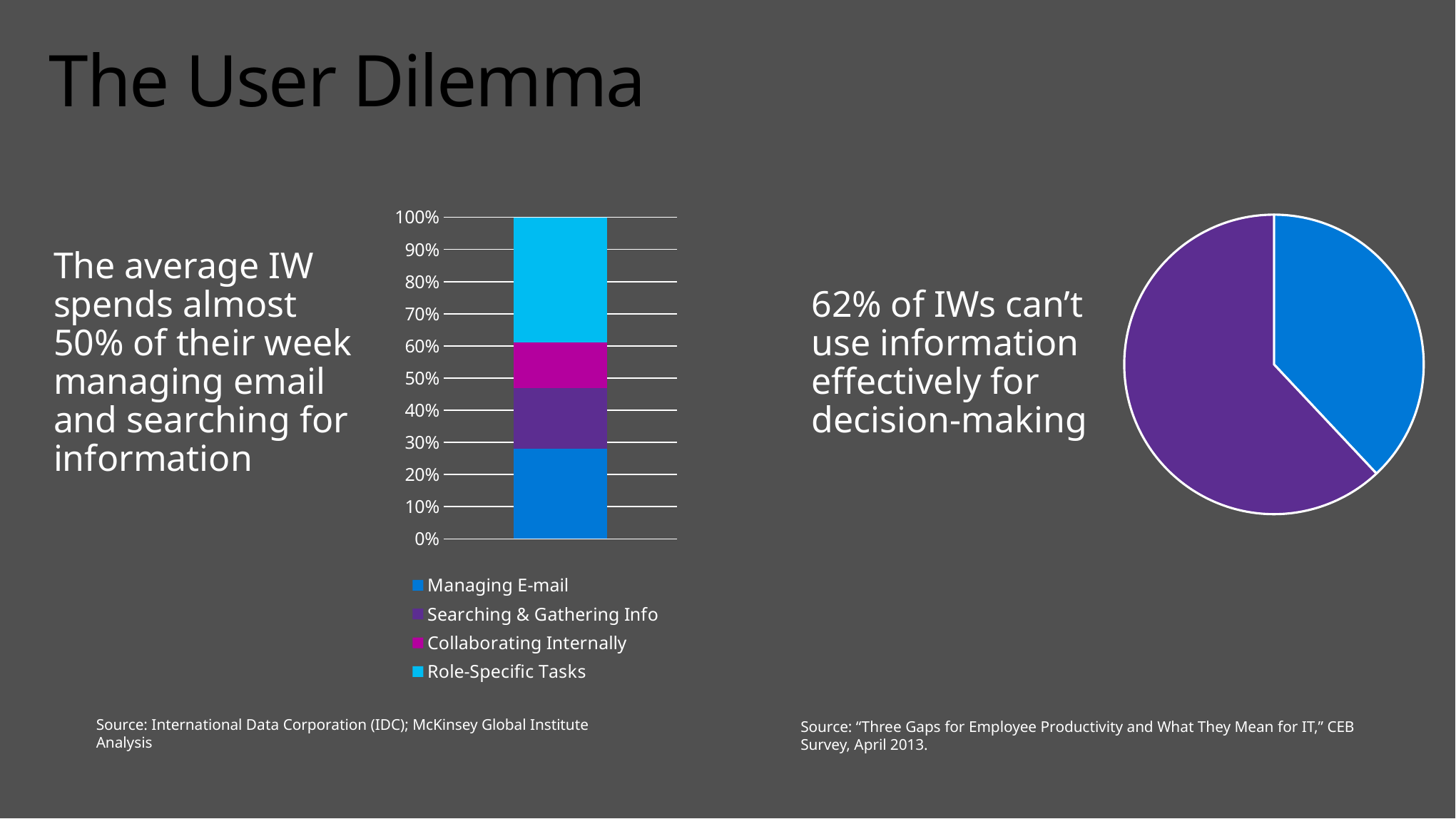
How many series does the legend of the left-hand bar chart list? 4 In the left-hand bar chart, is the value for Managing E-mail greater or less than 20%? greater In the pie chart on the right, is the purple slice greater or less than 50% of the pie? greater How many slices does the pie chart on the right have? 2 In the left-hand bar chart, is the value for Collaborating Internally greater or less than 20%? less What kind of chart is the chart on the right of the slide? pie chart In the left-hand bar chart, which is larger: Managing E-mail or Collaborating Internally? Managing E-mail In the left-hand bar chart, which series takes up the largest share of the stacked bar? Role-Specific Tasks What kind of chart is the chart on the left of the slide? bar chart In the left-hand bar chart, which series is shown in magenta? Collaborating Internally